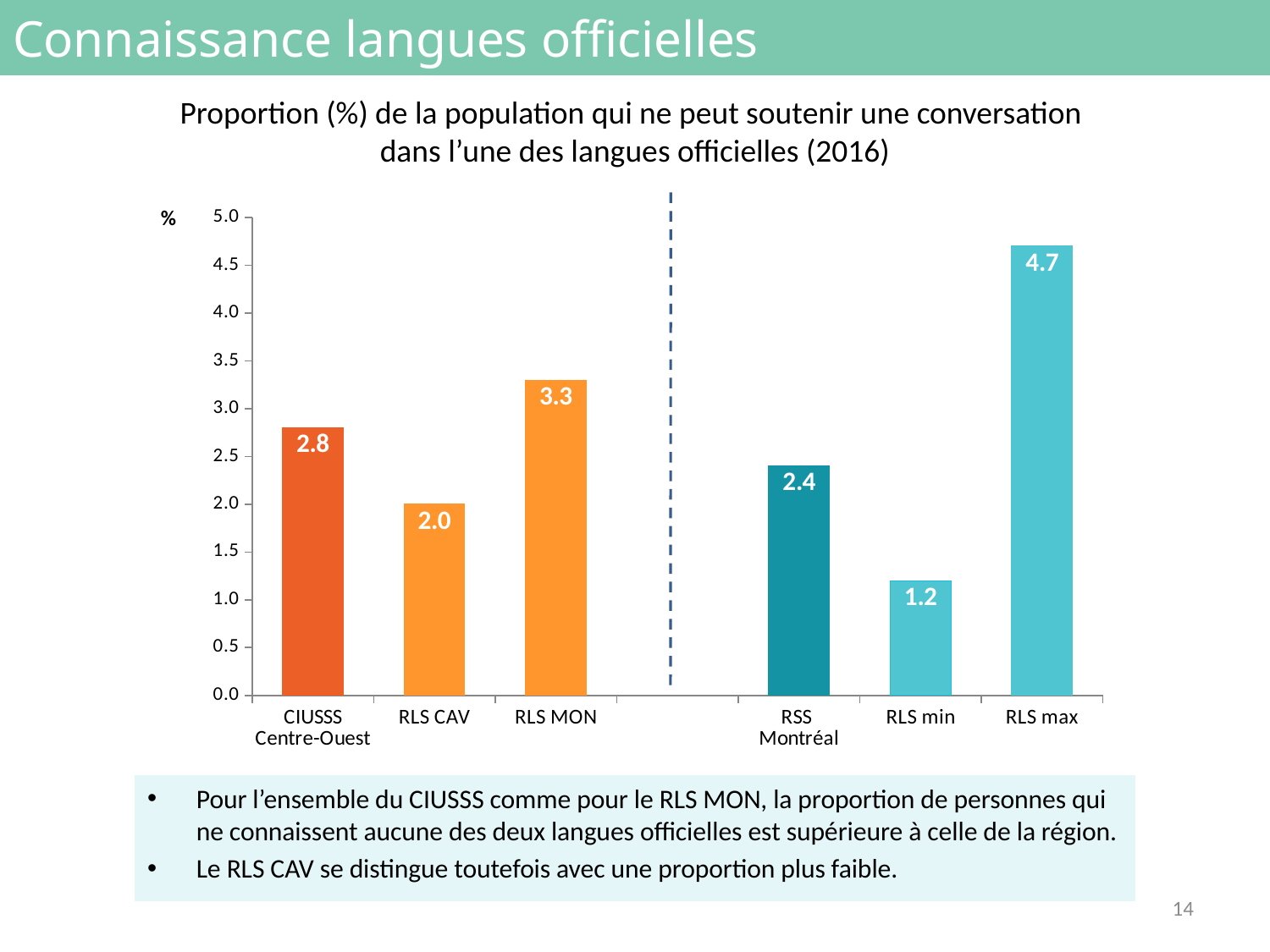
Which is larger, the value for CIUSSS Centre-Ouest or the value for RSS Montréal? CIUSSS Centre-Ouest What is the difference between the values for RLS max and RLS min? 3.5 What is the value for RSS Montréal? 2.4 Which category has the highest value? RLS max What kind of chart is shown on the slide? bar chart What is the value for RLS MON? 3.3 What year is given in the chart title? 2016 What is the difference between the values for RLS MON and RLS CAV? 1.3 How many categories are shown on the chart? 6 What is the value for CIUSSS Centre-Ouest? 2.8 Which category has the lowest value? RLS min Is the value for RLS CAV greater or less than 2.5? less